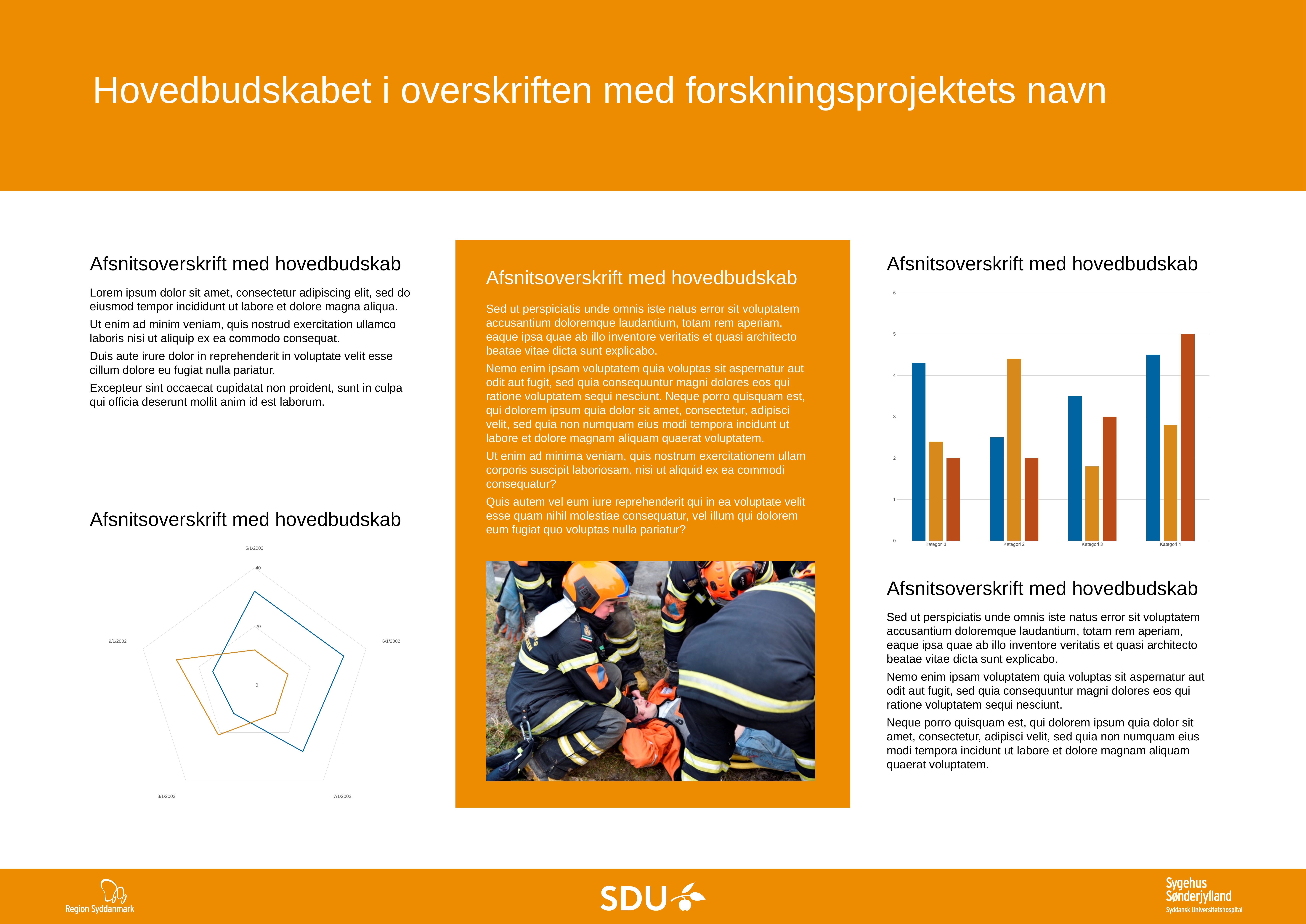
In the bar chart on the right, how many bars are shown for each category? 3 In the bar chart on the right, is the gold bar for Kategori 3 greater or less than 2? less In the radar chart in the lower left, is the blue series value at 5/1/2002 greater or less than 20? greater What kind of chart is the chart in the lower left of the slide with the date labels? radar chart In the bar chart on the right, is the blue bar for Kategori 1 greater or less than 4? greater In the bar chart on the right, which category contains the tallest bar? Kategori 4 In the radar chart in the lower left, how many axes (date labels) are there? 5 In the bar chart on the right, what is the value of the dark orange bar for Kategori 4? 5 What kind of chart is the chart on the right side of the slide with categories Kategori 1 to Kategori 4? bar chart In the bar chart on the right, which is larger for Kategori 2: the blue bar or the gold bar? the gold bar In the bar chart on the right, how many categories are shown on the x axis? 4